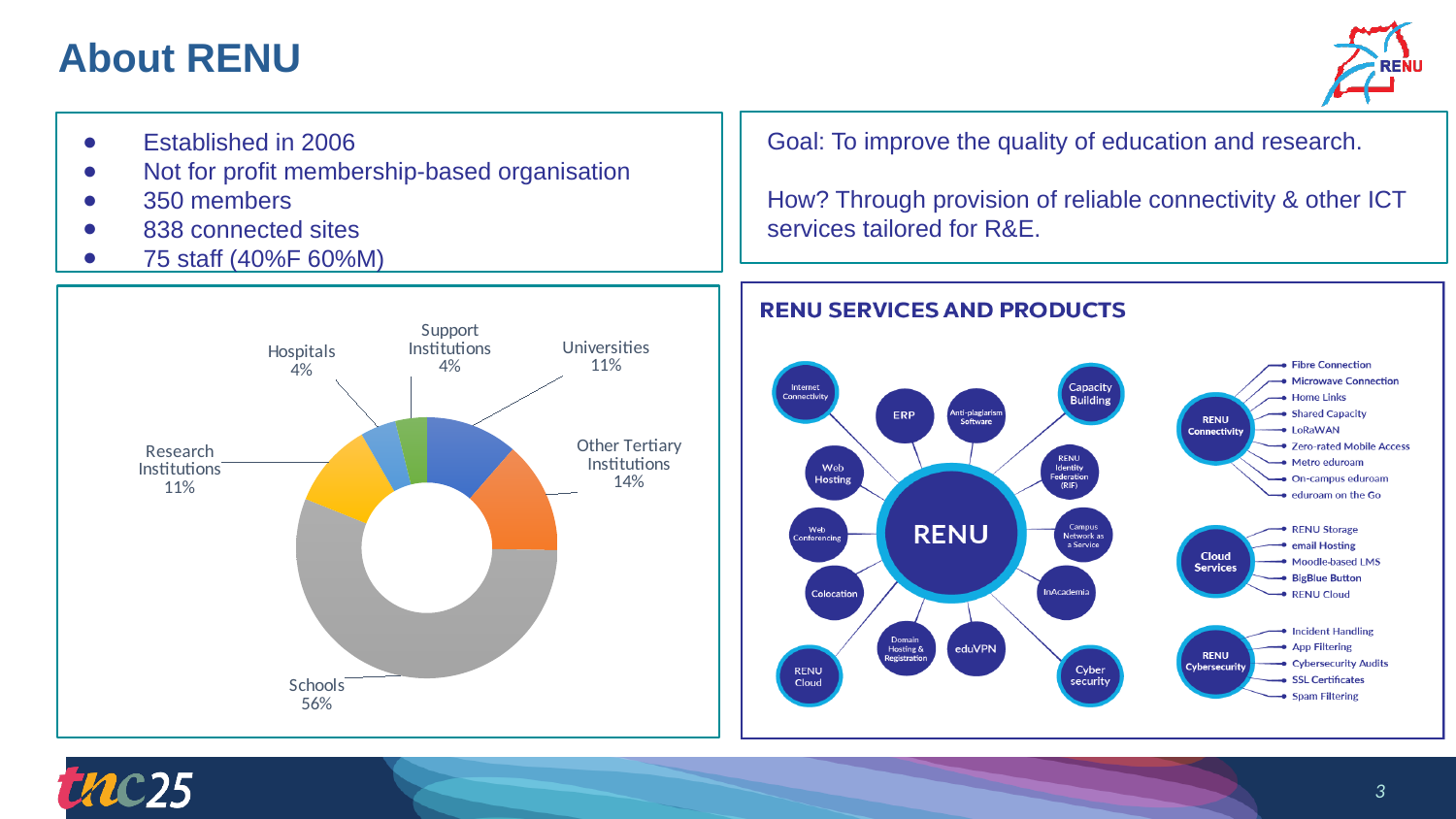
Which category has the largest share in the doughnut chart? Schools What percentage is shown for Hospitals in the doughnut chart? 4% What is the combined share of Universities and Research Institutions in the doughnut chart? 22% In the doughnut chart, which is larger: Other Tertiary Institutions or Research Institutions? Other Tertiary Institutions What is the difference in percentage points between Schools and Other Tertiary Institutions in the doughnut chart? 42 What percentage is shown for Universities in the doughnut chart? 11% Which two categories share the smallest value in the doughnut chart? Hospitals and Support Institutions What percentage is shown for Other Tertiary Institutions in the doughnut chart? 14% What kind of chart is used to show the membership breakdown on the slide? Doughnut chart How many categories are shown in the doughnut chart? 6 What share of the doughnut chart do Schools account for? 56% What is the difference in percentage points between Universities and Hospitals in the doughnut chart? 7